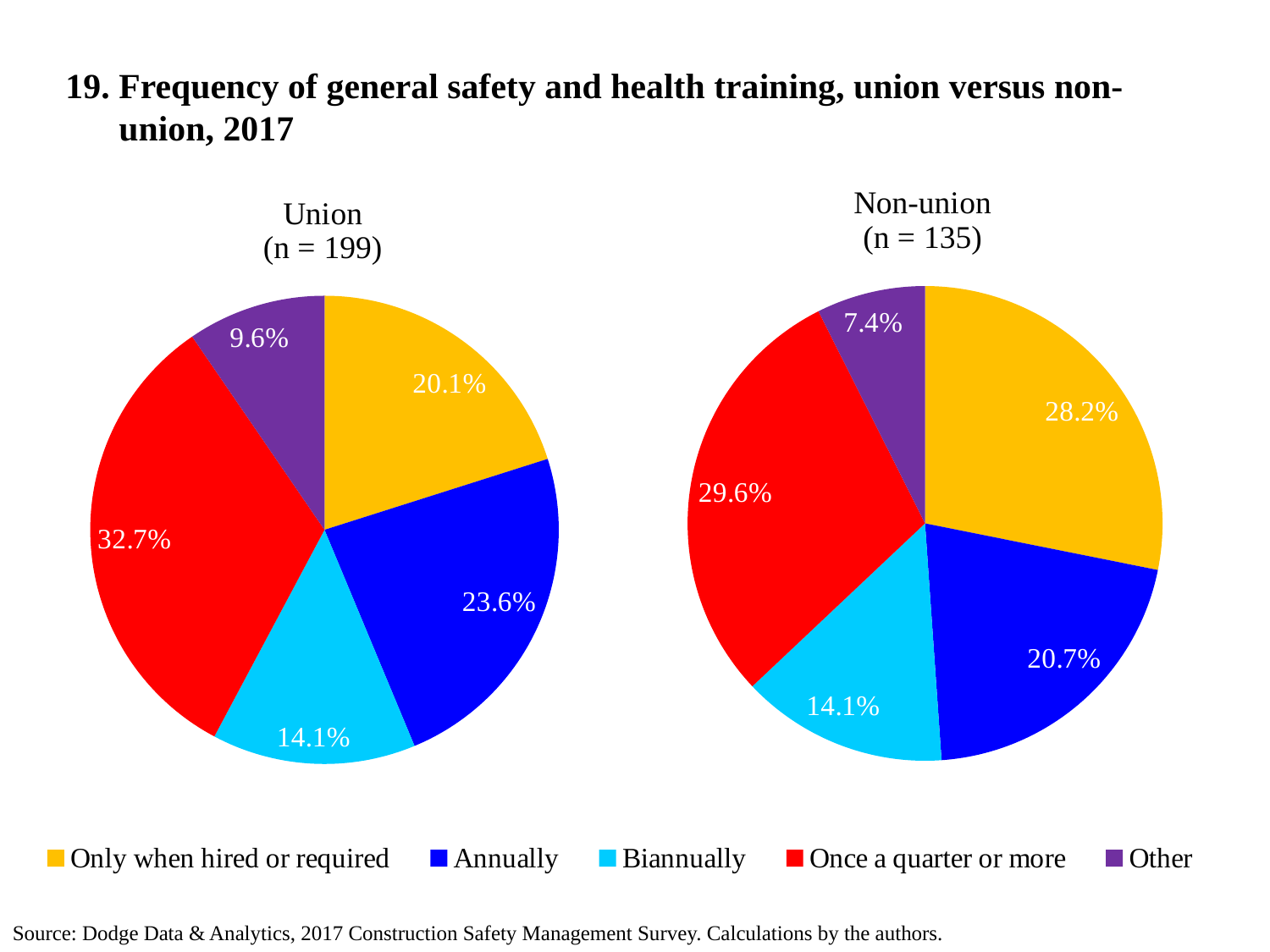
In the Union pie chart, what share is labelled for 'Once a quarter or more'? 32.7% In the Union pie chart, which category has the largest share? Once a quarter or more How many slices does the Union pie chart have? 5 In the Non-union pie chart, what share is labelled for 'Other'? 7.4% What is the sample size (n) shown for the Non-union chart? 135 What type of chart is used on this slide? Pie chart Which is larger: the 'Only when hired or required' share in the Union chart or in the Non-union chart? Non-union In the Union pie chart, what share is labelled for 'Annually'? 23.6% What is the difference between the 'Once a quarter or more' share in the Union chart and in the Non-union chart? 3.1% In the Non-union pie chart, which category has the smallest share? Other In the Union pie chart, which category has the smallest share? Other In the Non-union pie chart, what share is labelled for 'Only when hired or required'? 28.2%